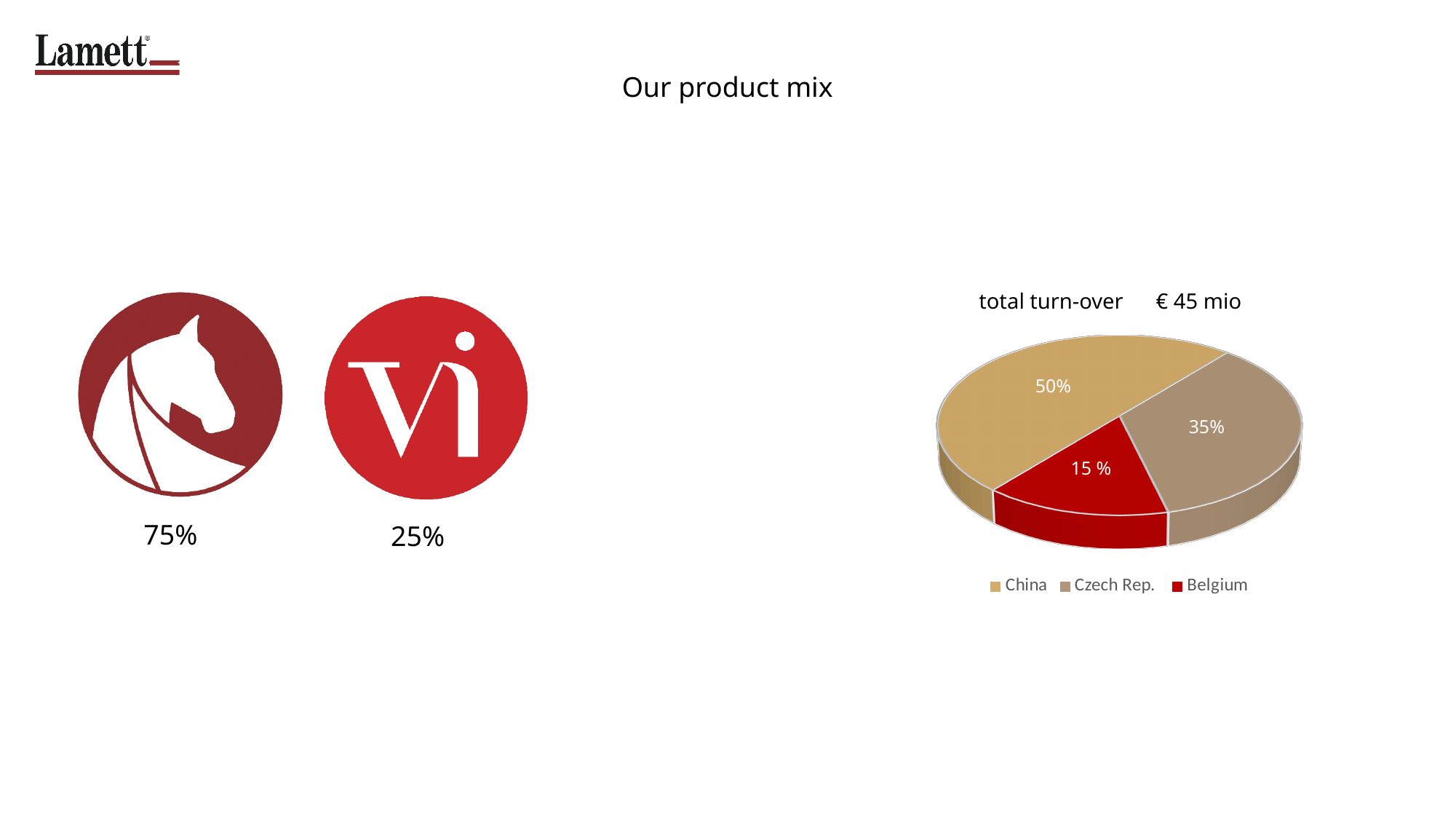
What share of the pie does Belgium have? 15 % What share of the pie does Czech Rep. have? 35% Which is larger, the share for Czech Rep. or the share for Belgium? Czech Rep. What kind of chart is shown on the slide? pie chart What share of the pie does China have? 50% How many slices does the pie chart have? 3 What is the difference in percentage points between China's and Czech Rep.'s shares? 15 What total turn-over is stated above the pie chart? € 45 mio Which colour represents Belgium in the pie chart? red Which category has the largest slice of the pie? China How many entries does the legend list? 3 Which category has the smallest slice of the pie? Belgium